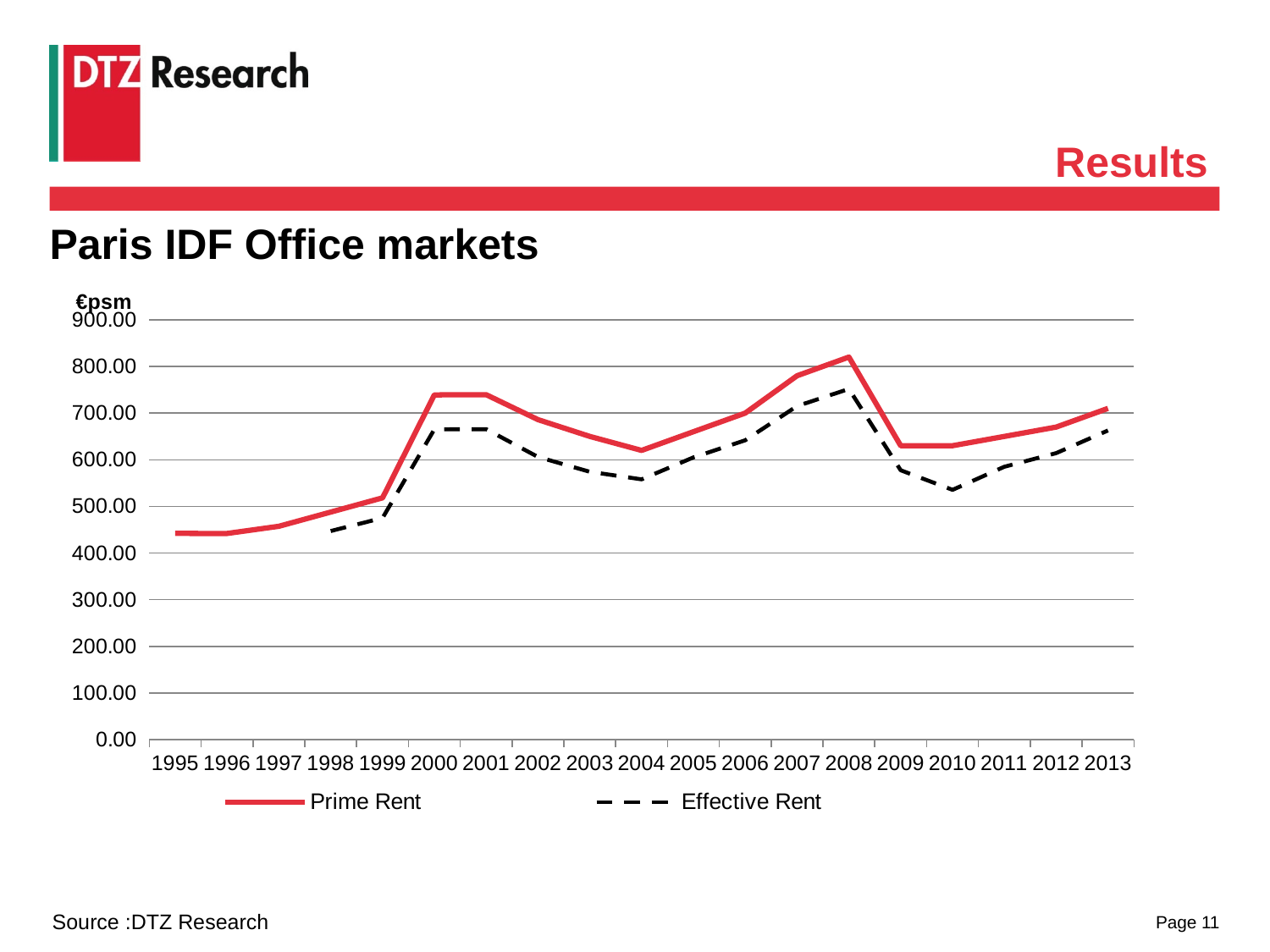
Does Prime Rent rise or fall from 2008 to 2009? Fall Is the Prime Rent value for 2008 greater or less than 800? greater Is the Effective Rent value for 2010 greater or less than 600? less Is the Prime Rent value for 1995 greater or less than 500? less What unit is shown at the top of the y axis? €psm Does Prime Rent rise or fall from 2009 to 2013? Rise Which is larger in 2008, Prime Rent or Effective Rent? Prime Rent In which year does Prime Rent reach its highest value? 2008 What kind of chart is shown on the slide? Line chart In which year does Effective Rent reach its highest value? 2008 How many series does the legend list? 2 How many years are shown along the x axis? 19